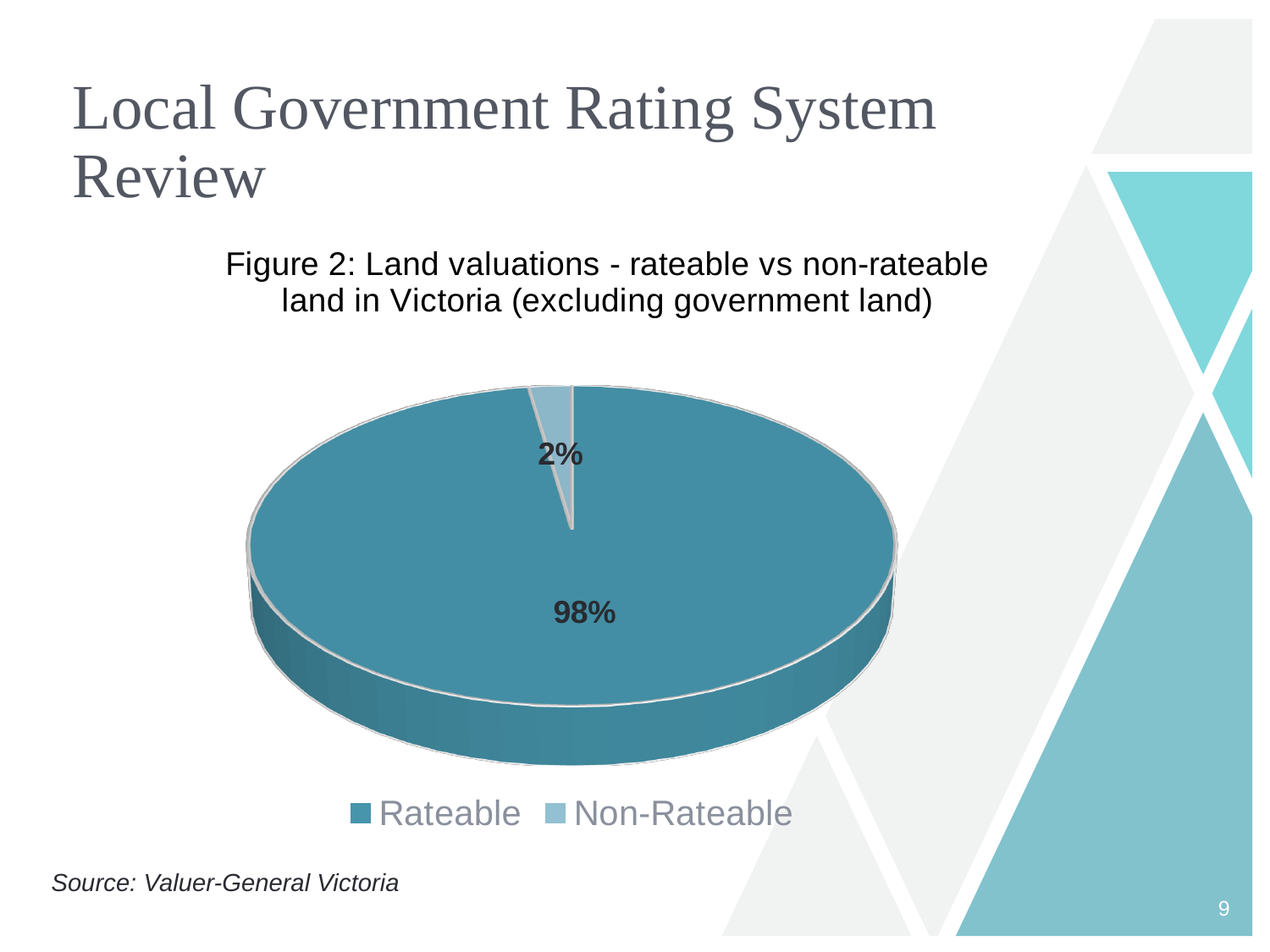
What is the source cited for the chart? Valuer-General Victoria How many entries does the legend list? 2 How many slices does the pie chart have? 2 What share of land valuations is Non-Rateable? 2% Which category has the largest slice of the pie? Rateable What is the difference in percentage points between the Rateable and Non-Rateable slices? 96 What kind of chart is shown on the slide? Pie chart Which category has the smallest slice of the pie? Non-Rateable What share of land valuations is Rateable? 98% What is the title of the chart? Figure 2: Land valuations - rateable vs non-rateable land in Victoria (excluding government land) Which is larger, the Rateable slice or the Non-Rateable slice? Rateable